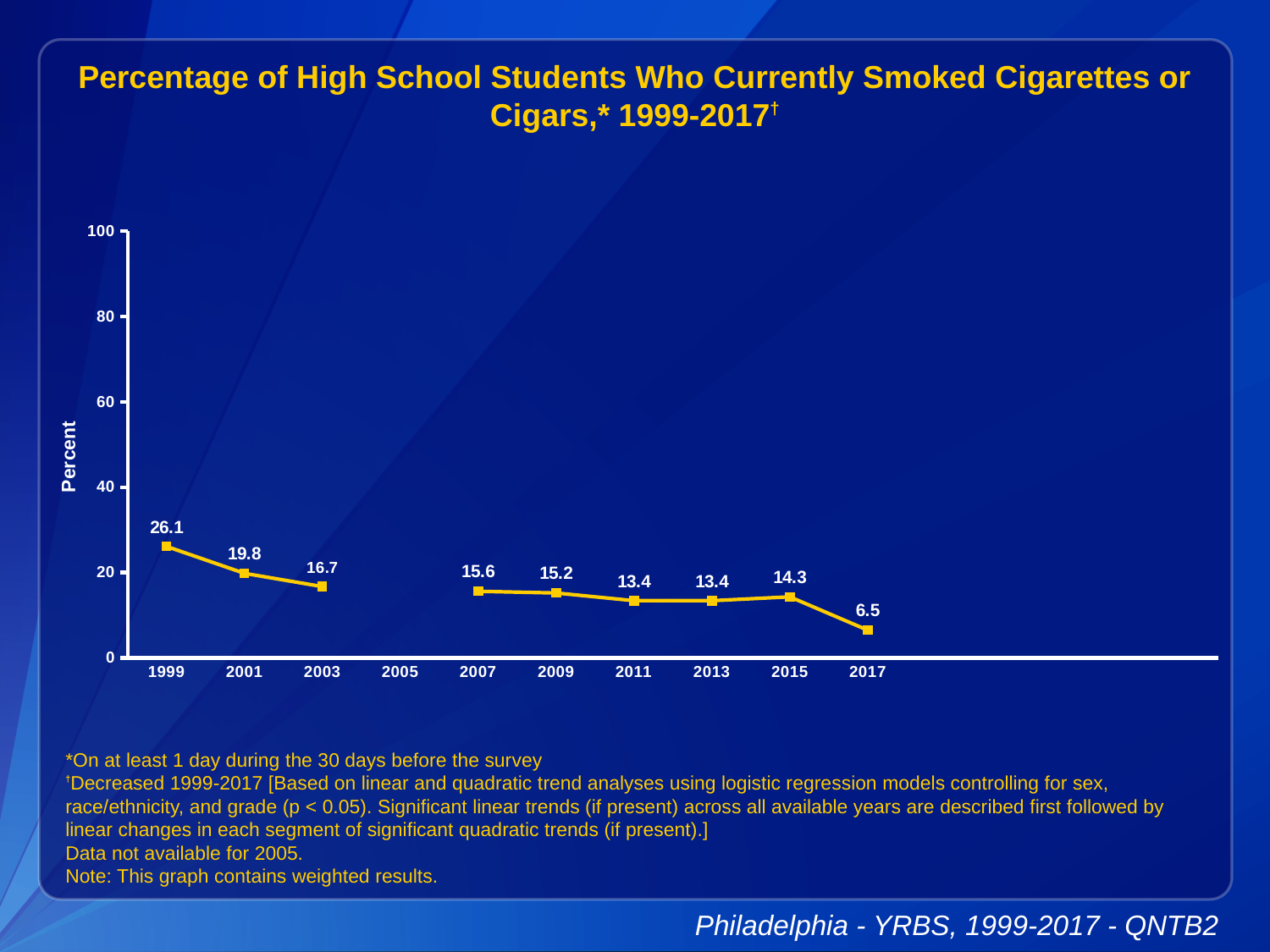
Is the value for 2003 greater or less than 20? less Which is larger, the value for 2007 or the value for 2015? 2007 What is the value for 2017? 6.5 What is the value for 2009? 15.2 Which year has the lowest value? 2017 What is the value for 1999? 26.1 Which year has the highest value? 1999 Do the values generally rise or fall from 1999 to 2017? fall What kind of chart is shown? line chart What is the label on the y axis? Percent What is the difference between the values for 1999 and 2017? 19.6 How many years have data points plotted on the chart? 9